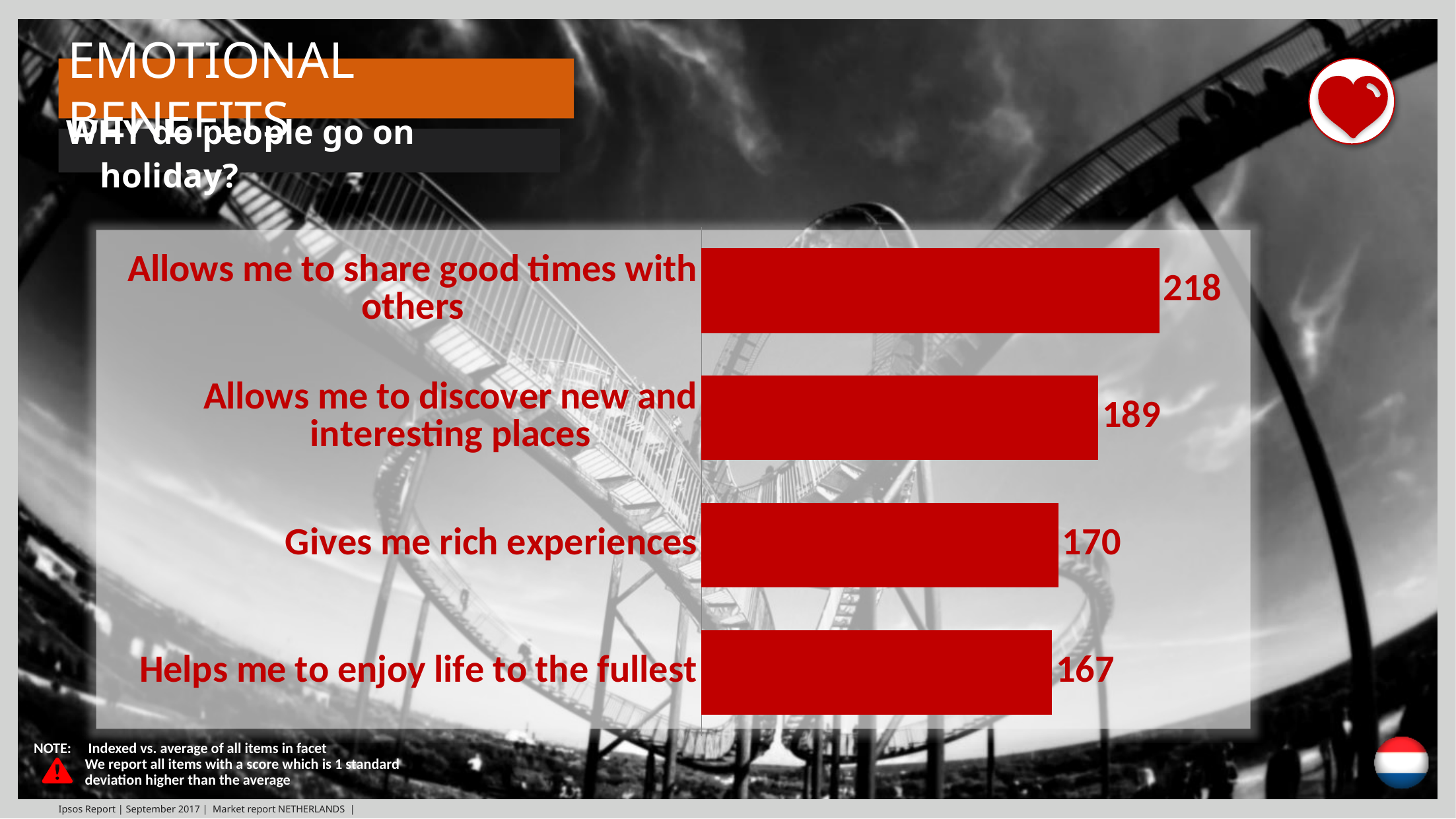
What colour are the bars in the chart? Red What is the value for 'Allows me to share good times with others'? 218 How many categories are shown in the chart? 4 What is the value for 'Gives me rich experiences'? 170 What kind of chart is shown on the slide? Bar chart What is the value for 'Helps me to enjoy life to the fullest'? 167 Which is larger: the value for 'Allows me to discover new and interesting places' or 'Gives me rich experiences'? Allows me to discover new and interesting places Which category has the highest value? Allows me to share good times with others Which category has the lowest value? Helps me to enjoy life to the fullest What is the value for 'Allows me to discover new and interesting places'? 189 What is the difference between the values for 'Allows me to share good times with others' and 'Allows me to discover new and interesting places'? 29 What is the difference between the values for 'Gives me rich experiences' and 'Helps me to enjoy life to the fullest'? 3